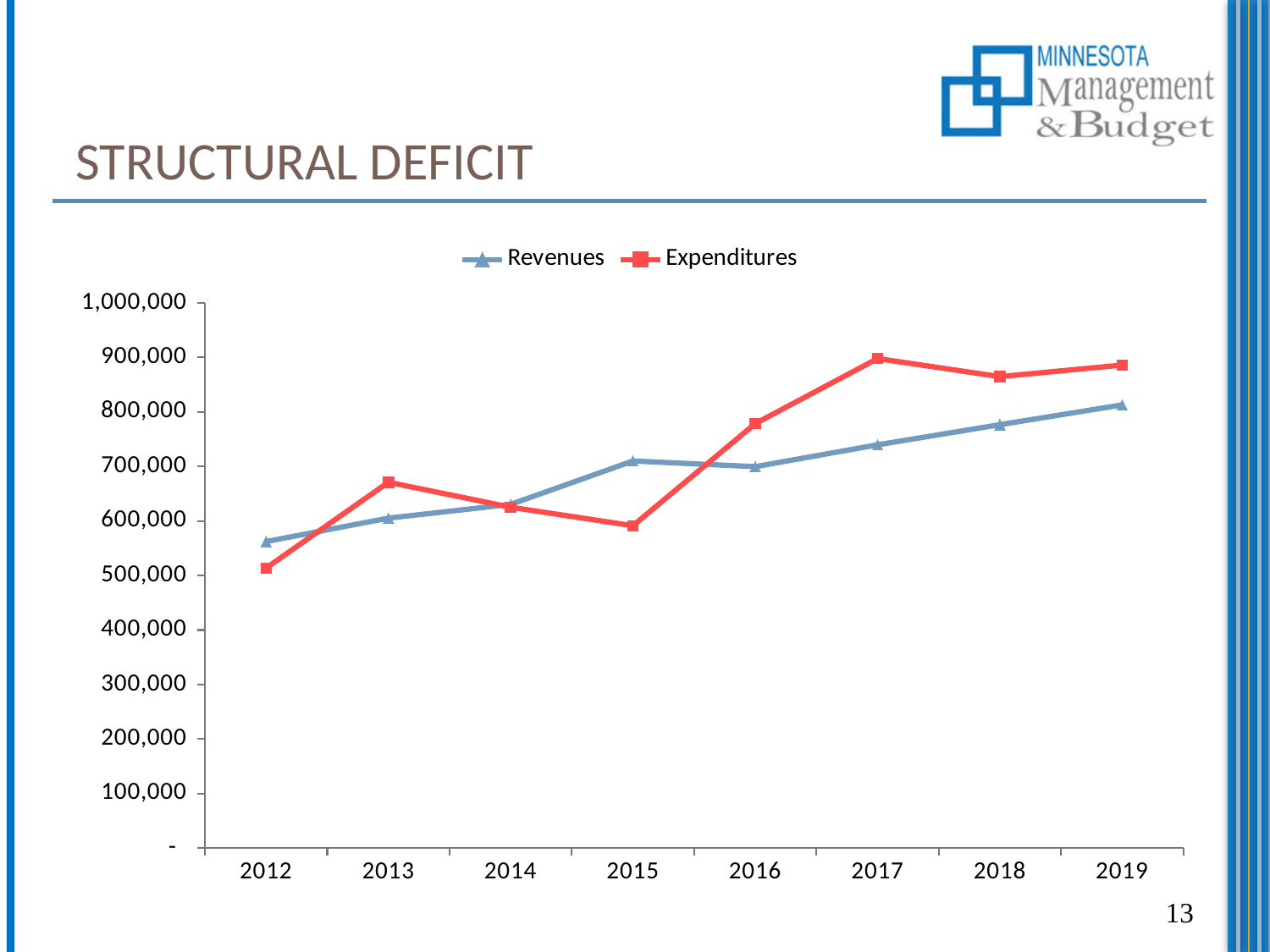
What kind of chart is shown on the slide? line chart In which year are Expenditures lowest? 2012 In which year are Revenues highest? 2019 In which year are Revenues lowest? 2012 Is the value for Revenues in 2012 greater or less than 600,000? less In 2015, which is larger, Revenues or Expenditures? Revenues Is the value for Expenditures in 2017 greater or less than 800,000? greater How many years are plotted along the x axis? 8 What is the title of the slide containing the chart? STRUCTURAL DEFICIT How many series does the legend list? 2 In 2017, which is larger, Revenues or Expenditures? Expenditures In which year are Expenditures highest? 2017